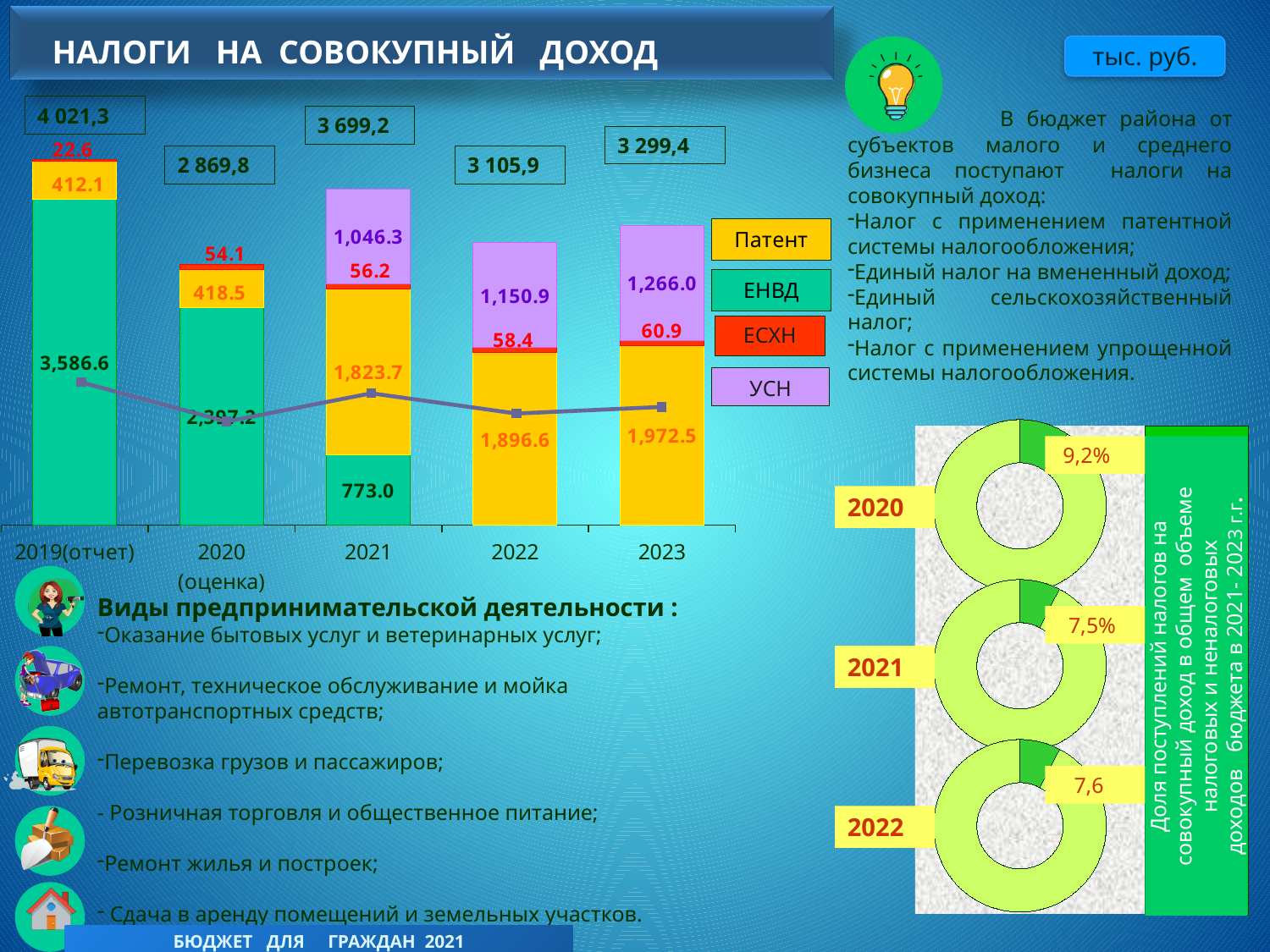
In the main bar chart, what is the value of УСН for 2023? 1,266.0 In the main bar chart, what is the value of Патент for 2021? 1,823.7 In the main bar chart, which year has the lowest total? 2020 In the main bar chart, which year has the highest total? 2019(отчет) In the donut charts on the right, what share is shown for 2020? 9,2% What kind of chart is the main chart on the left of the slide? bar chart In the main bar chart, does ЕСХН rise or fall from 2019 to 2023? rises In the main bar chart, what is the total shown above the bar for 2022? 3 105,9 In the main bar chart, how many years are shown on the x axis? 5 In the main bar chart, what is the difference between the Патент values for 2023 and 2022? 75.9 In the main bar chart, how many series does the legend list? 4 In the main bar chart, what is the value of ЕНВД for 2019(отчет)? 3,586.6